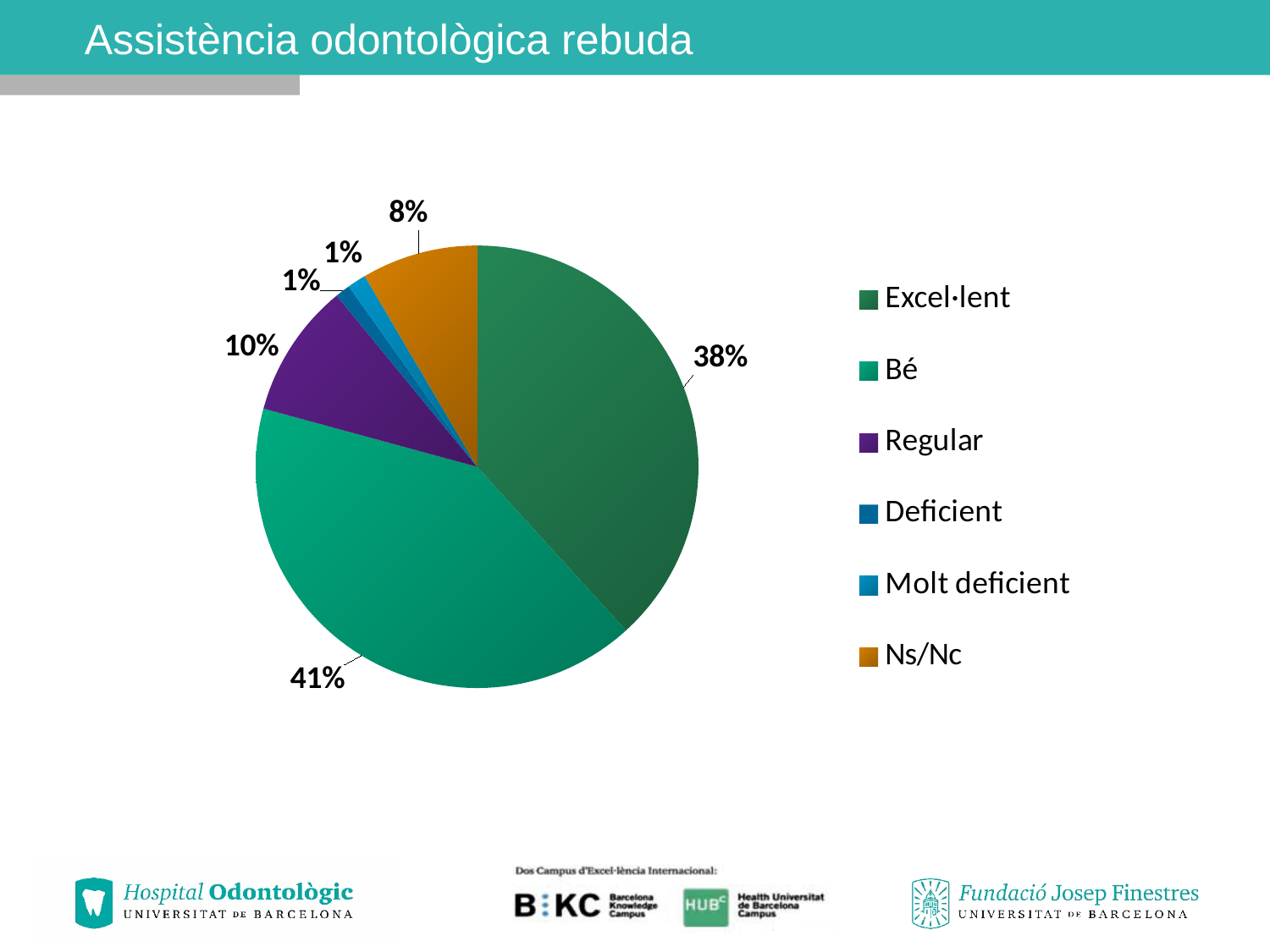
Which slice is larger, Regular or Ns/Nc? Regular What percentage of the pie is labelled Regular? 10% What is the title of the chart? Assistència odontològica rebuda What is the difference in percentage points between the Bé and Excel·lent slices? 3 Which category has the largest share of the pie? Bé What percentage of the pie is labelled Ns/Nc? 8% What percentage of the pie is labelled Bé? 41% What percentage of the pie is labelled Excel·lent? 38% What type of chart is shown on the slide? pie chart How many categories does the legend list? 6 What percentage of the pie is labelled Deficient? 1% What is the combined share of the Excel·lent and Bé slices? 79%